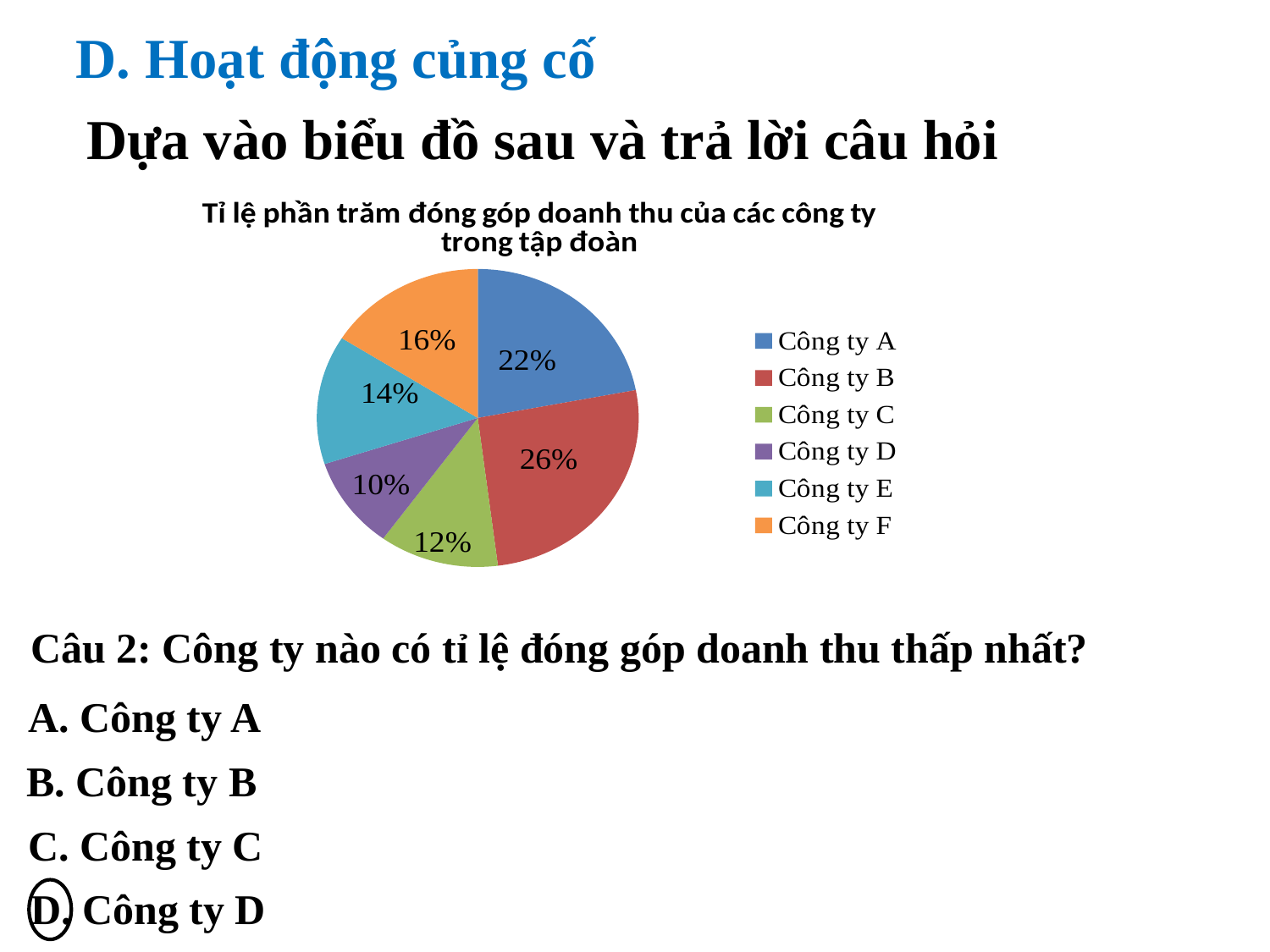
What is the title of the chart? Tỉ lệ phần trăm đóng góp doanh thu của các công ty trong tập đoàn Which contributes a larger share, Công ty F or Công ty E? Công ty F What is the combined share of Công ty C and Công ty D? 22% What percentage of revenue does Công ty A contribute? 22% What type of chart is shown on the slide? pie chart What percentage of revenue does Công ty B contribute? 26% What is the difference between the shares of Công ty B and Công ty C? 14% What percentage of revenue does Công ty E contribute? 14% What colour is the slice for Công ty D? purple How many companies are shown in the pie chart? 6 Which company has the largest share of revenue? Công ty B Which company has the smallest share of revenue? Công ty D